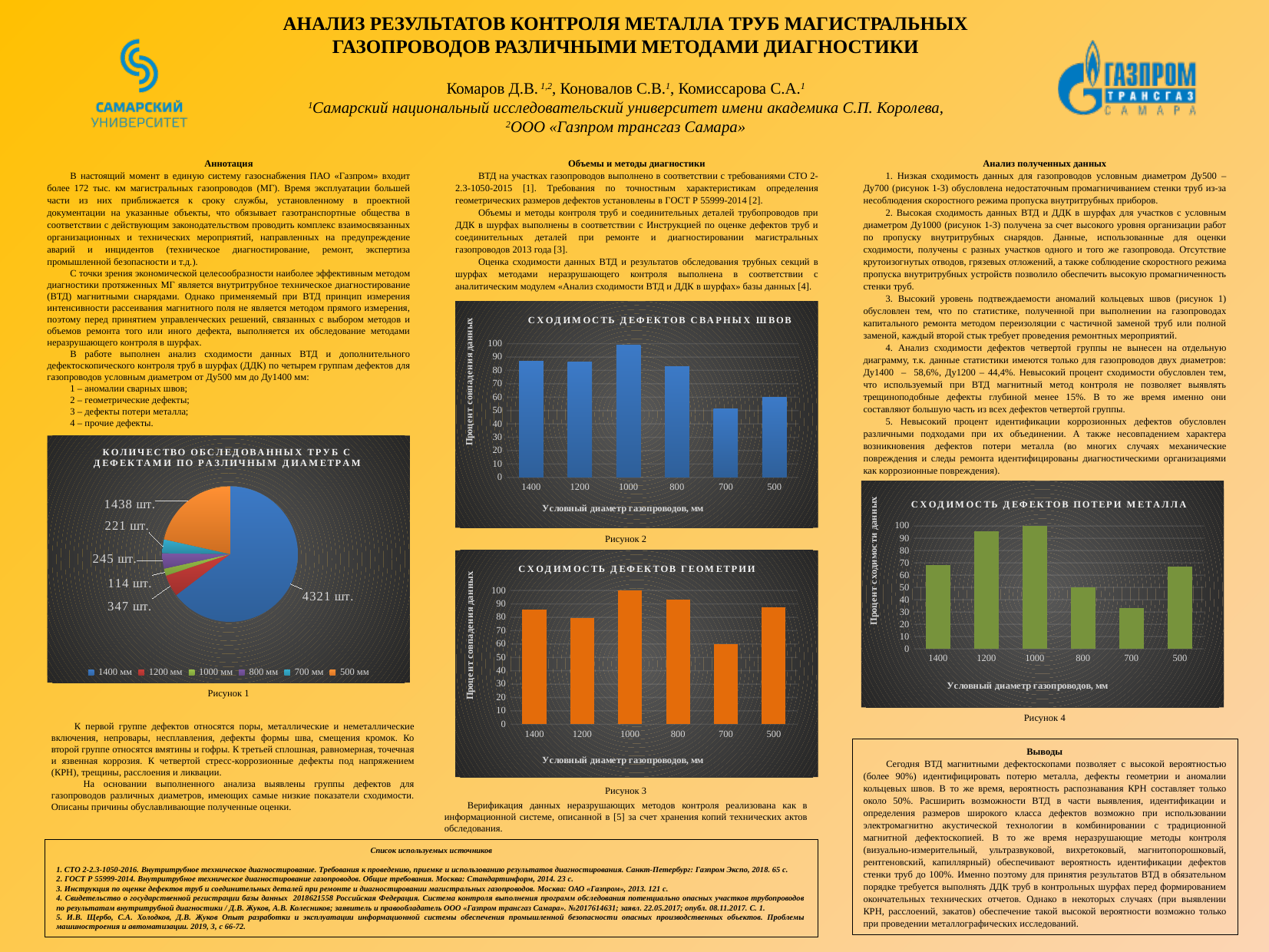
In the chart 'СХОДИМОСТЬ ДЕФЕКТОВ СВАРНЫХ ШВОВ' (Рисунок 2), which diameter has the highest bar? 1000 In the pie chart (Рисунок 1), which diameter has the largest slice? 1400 мм In the pie chart 'КОЛИЧЕСТВО ОБСЛЕДОВАННЫХ ТРУБ С ДЕФЕКТАМИ ПО РАЗЛИЧНЫМ ДИАМЕТРАМ' (Рисунок 1), what value is shown for the largest slice? 4321 шт. In the chart 'СХОДИМОСТЬ ДЕФЕКТОВ ГЕОМЕТРИИ' (Рисунок 3), is the value for 1000 greater or less than 90? greater In the chart 'СХОДИМОСТЬ ДЕФЕКТОВ ГЕОМЕТРИИ' (Рисунок 3), which diameter has the lowest bar? 700 In the chart 'СХОДИМОСТЬ ДЕФЕКТОВ СВАРНЫХ ШВОВ' (Рисунок 2), is the value for 700 greater or less than 60? less How many diameter categories are shown on the x axis of the chart 'СХОДИМОСТЬ ДЕФЕКТОВ ПОТЕРИ МЕТАЛЛА' (Рисунок 4)? 6 In the pie chart (Рисунок 1), what is the difference between the 4321 шт. slice and the 1438 шт. slice? 2883 шт. What type of chart is Рисунок 1? Pie chart In the pie chart (Рисунок 1), how many slices does the legend list? 6 What type of chart is 'СХОДИМОСТЬ ДЕФЕКТОВ СВАРНЫХ ШВОВ' (Рисунок 2)? Bar chart In the chart 'СХОДИМОСТЬ ДЕФЕКТОВ ПОТЕРИ МЕТАЛЛА' (Рисунок 4), which is larger, the value for 1200 or the value for 800? 1200